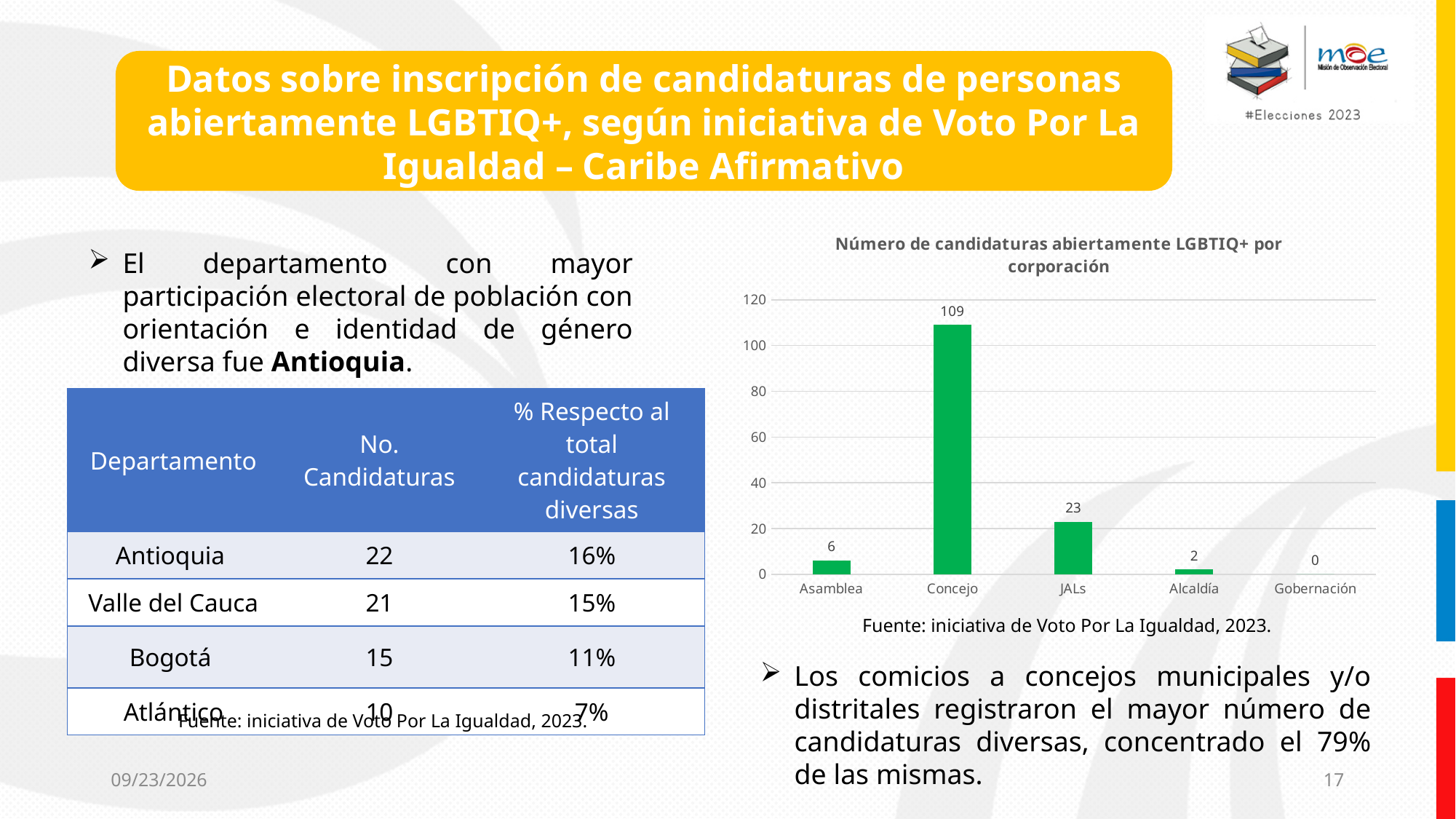
How many categories are shown on the x axis of the chart? 5 What is the value for Gobernación in the chart? 0 Is the value for Concejo greater or less than 100? greater What is the difference between the values for Concejo and JALs? 86 Which corporación has the highest number of candidaturas in the chart? Concejo What is the value for Alcaldía in the chart? 2 Which corporación has the lowest number of candidaturas in the chart? Gobernación What is the value for Concejo in the chart? 109 Which is larger, the value for Asamblea or the value for Alcaldía? Asamblea What type of chart is shown on the slide? Bar chart What is the value for JALs in the chart? 23 What is the value for Asamblea in the chart? 6